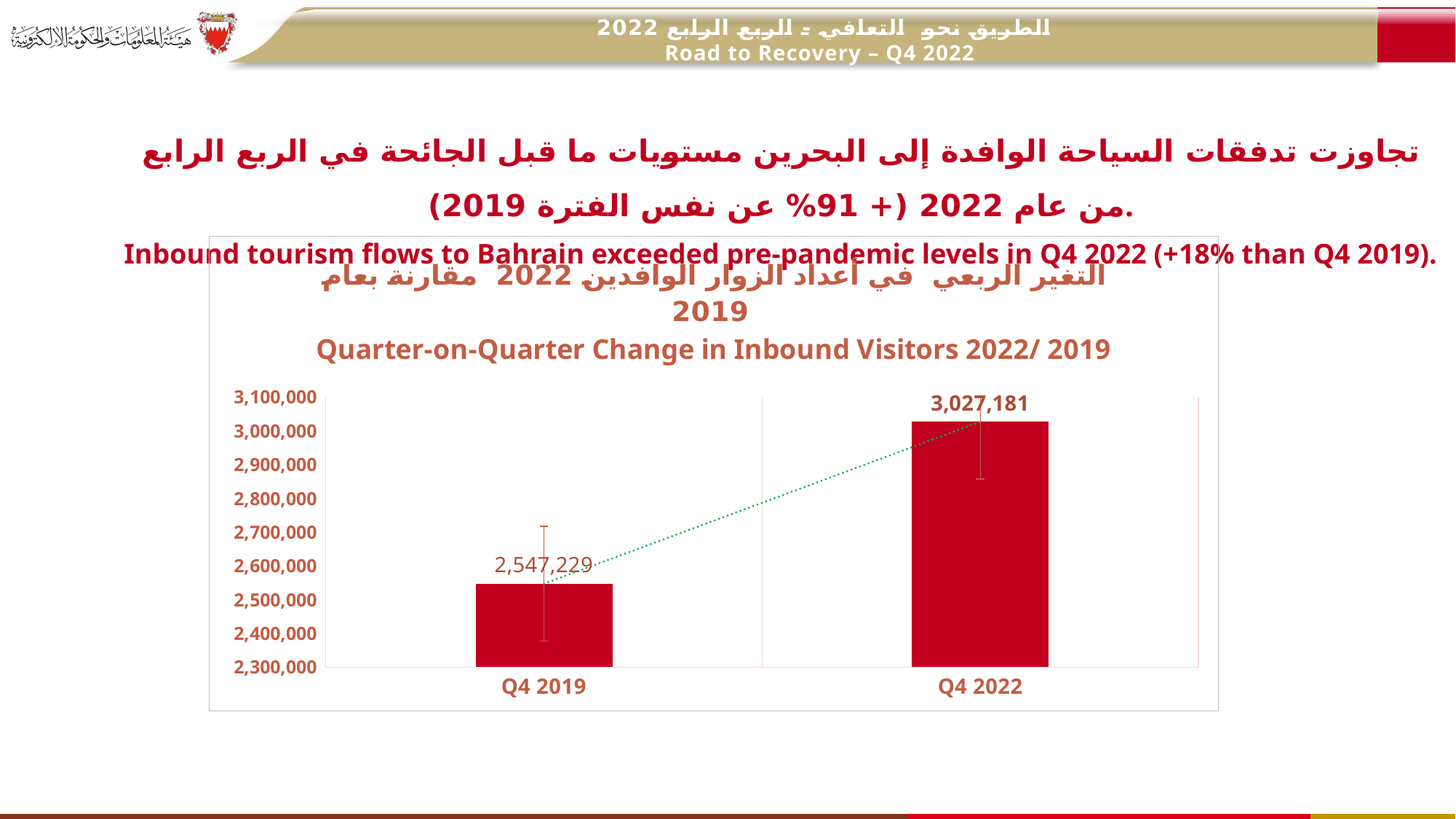
Do the values rise or fall from Q4 2019 to Q4 2022? rise What is the value for Q4 2022 in the chart? 3,027,181 What is the English title of the chart? Quarter-on-Quarter Change in Inbound Visitors 2022/ 2019 What kind of chart is shown on the slide? bar chart Which category has the lowest value in the chart? Q4 2019 Which is larger, the value for Q4 2019 or the value for Q4 2022? Q4 2022 Is the value for Q4 2022 greater or less than 3,000,000? greater How many categories are shown on the x axis of the chart? 2 What is the difference between the values for Q4 2022 and Q4 2019? 479,952 Which category has the highest value in the chart? Q4 2022 Is the value for Q4 2019 greater or less than 2,600,000? less What is the value for Q4 2019 in the chart? 2,547,229